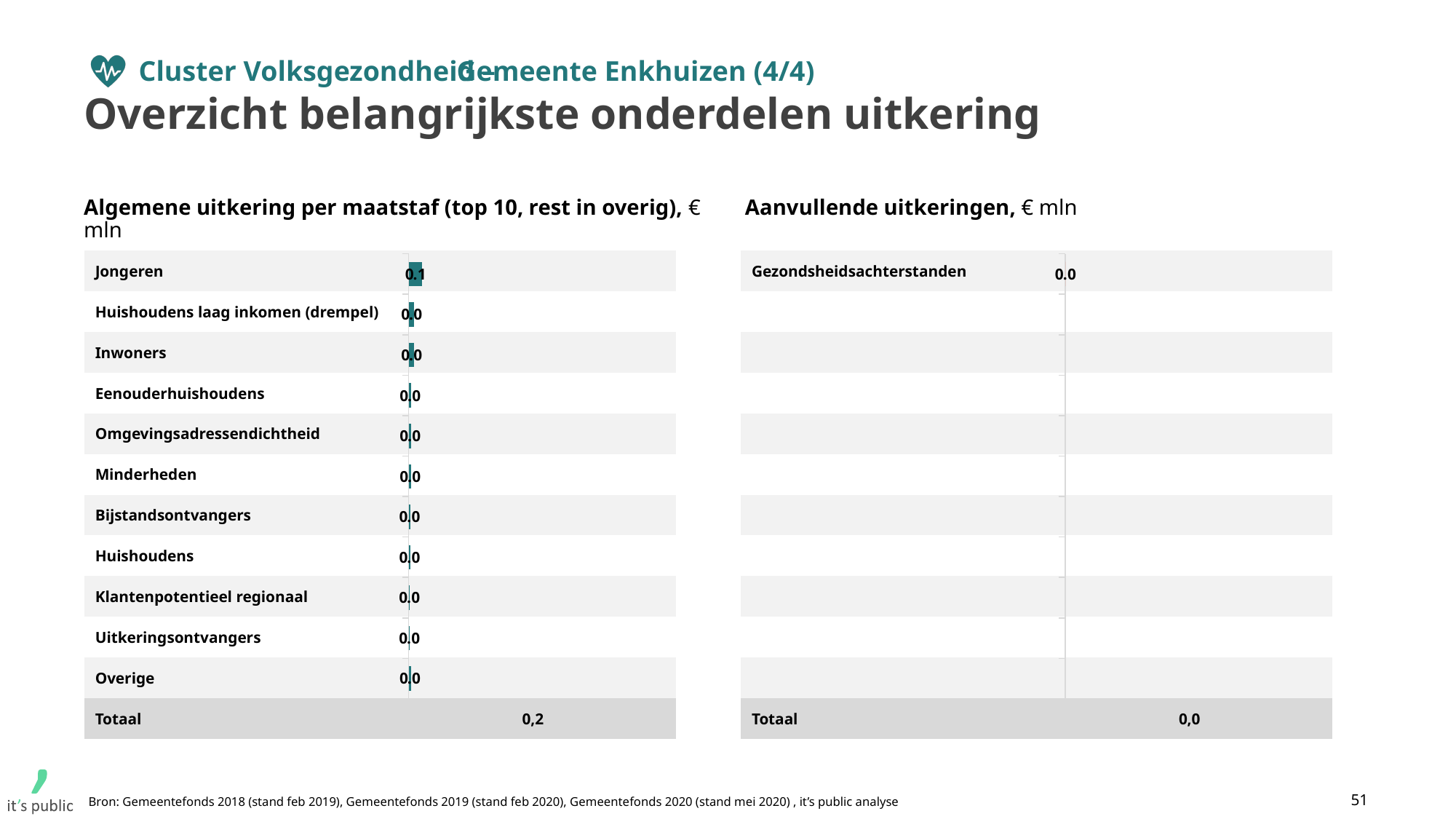
How many categories (excluding the Totaal row) are shown in the chart 'Algemene uitkering per maatstaf'? 11 In what unit are the values in the chart 'Aanvullende uitkeringen' expressed? € mln What kind of chart is 'Algemene uitkering per maatstaf'? Bar chart In the chart 'Aanvullende uitkeringen', what is the Totaal value? 0,0 In the chart 'Algemene uitkering per maatstaf', what is the value for Jongeren? 0,1 In the chart 'Algemene uitkering per maatstaf', what is the difference between the value for Jongeren and the value for Inwoners? 0,1 In the chart 'Algemene uitkering per maatstaf', which is larger: the value for Jongeren or the value for Inwoners? Jongeren In the chart 'Algemene uitkering per maatstaf', what is the value for Overige? 0,0 How many categories (excluding the Totaal row) are shown in the chart 'Aanvullende uitkeringen'? 1 In the chart 'Algemene uitkering per maatstaf', which category has the highest value? Jongeren In the chart 'Aanvullende uitkeringen', what is the value for Gezondheidsachterstanden? 0,0 In the chart 'Algemene uitkering per maatstaf', what is the Totaal value? 0,2